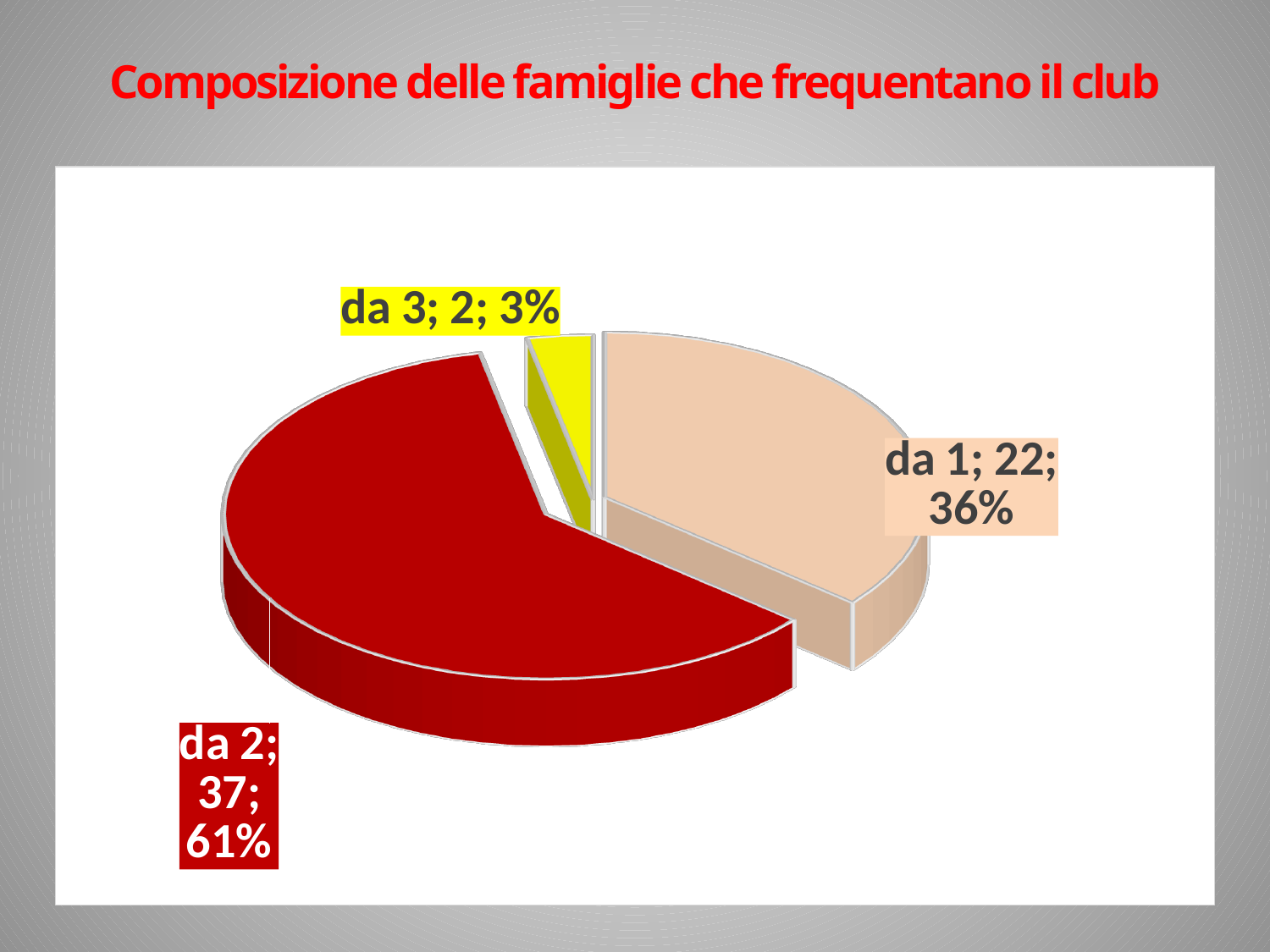
How many slices does the pie chart have? 3 Which category has the largest slice? da 2 What share of the pie does 'da 2' represent? 61% What share of the pie does 'da 1' represent? 36% What is the value for 'da 1'? 22 What is the difference between the values for 'da 2' and 'da 1'? 15 What is the value for 'da 3'? 2 Which category has the smallest slice? da 3 What kind of chart is shown on the slide? pie chart What share of the pie does 'da 3' represent? 3% What is the title of the chart? Composizione delle famiglie che frequentano il club What is the value for 'da 2'? 37